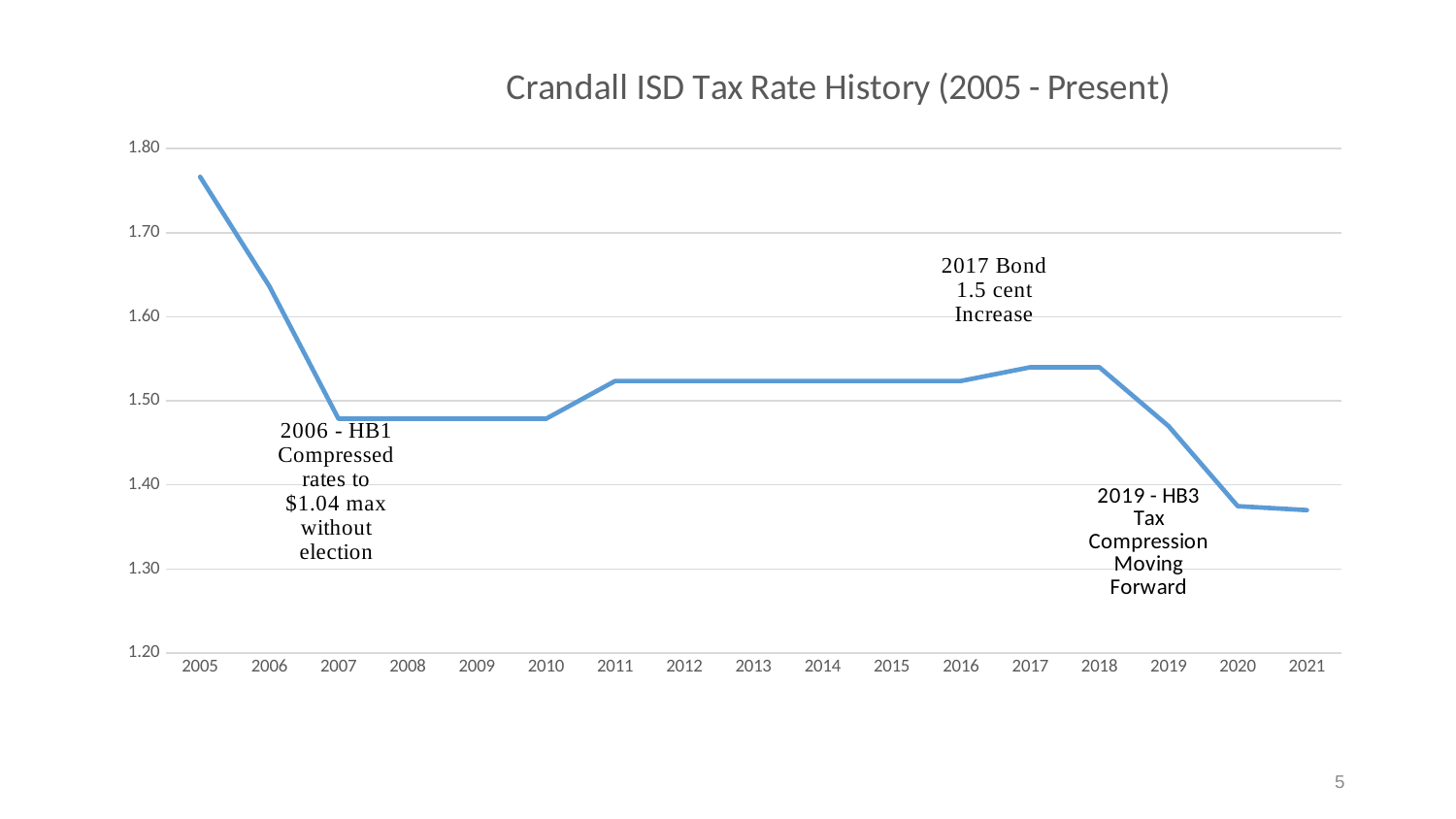
What is the title of the chart? Crandall ISD Tax Rate History (2005 - Present) Is the value for 2007 greater or less than 1.50? less Which year has the larger tax rate, 2010 or 2017? 2017 Does the tax rate rise or fall from 2018 to 2020? fall Which year has the larger tax rate, 2005 or 2021? 2005 Is the value for 2020 greater or less than 1.40? less What kind of chart is shown on the slide? line chart Which year has the highest tax rate? 2005 Is the value for 2017 greater or less than 1.50? greater How many years are plotted along the x axis? 17